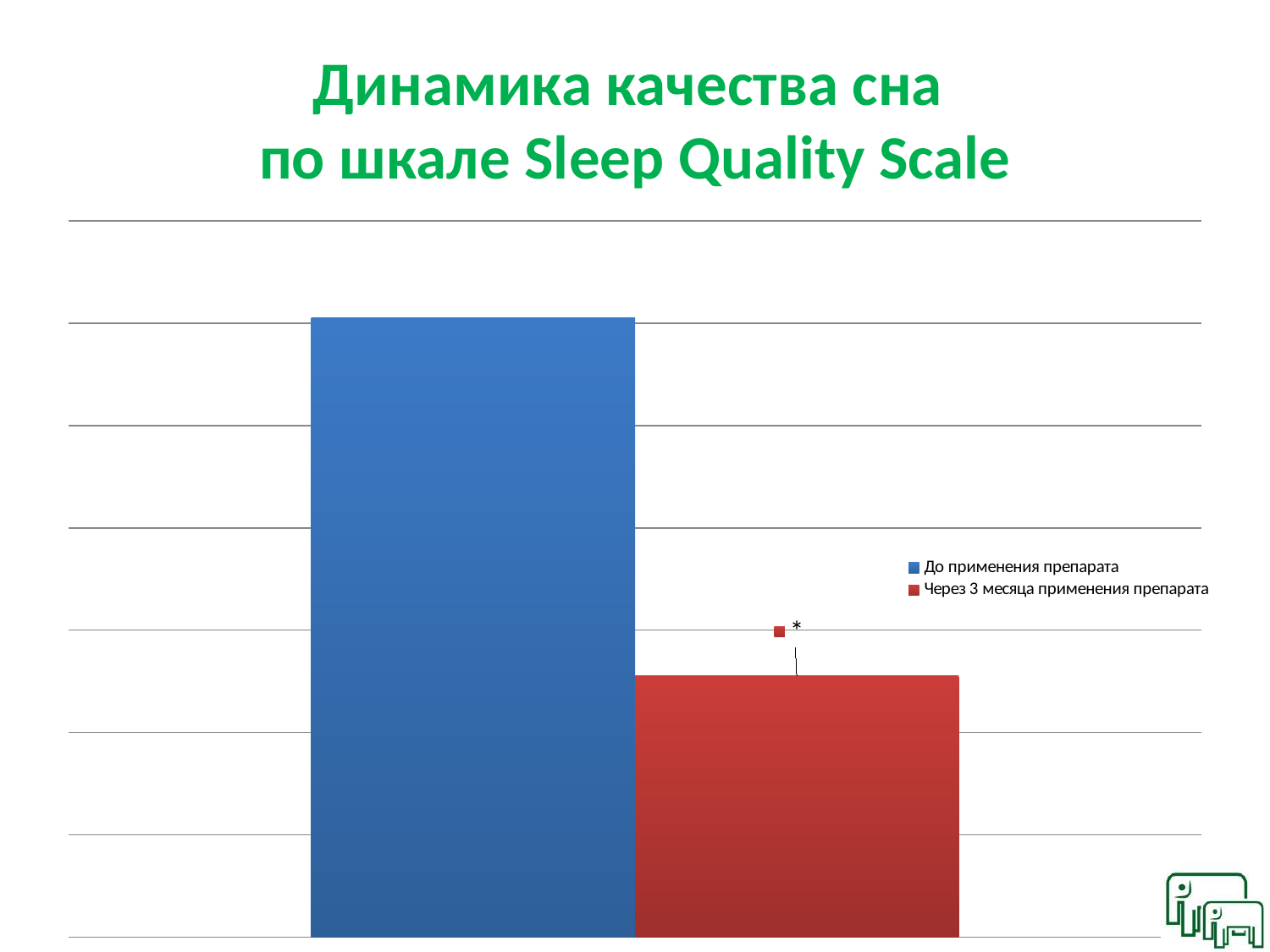
Which series has the highest value in the chart? До применения препарата How many series does the legend list? 2 Does the value rise or fall from "До применения препарата" to "Через 3 месяца применения препарата"? fall Which series has the lowest value in the chart? Через 3 месяца применения препарата Which series has the taller bar, "До применения препарата" or "Через 3 месяца применения препарата"? До применения препарата How many bars are plotted in the chart? 2 What kind of chart is shown on the slide? bar chart What colour is the bar for "Через 3 месяца применения препарата"? red What is the title of the chart on the slide? Динамика качества сна по шкале Sleep Quality Scale